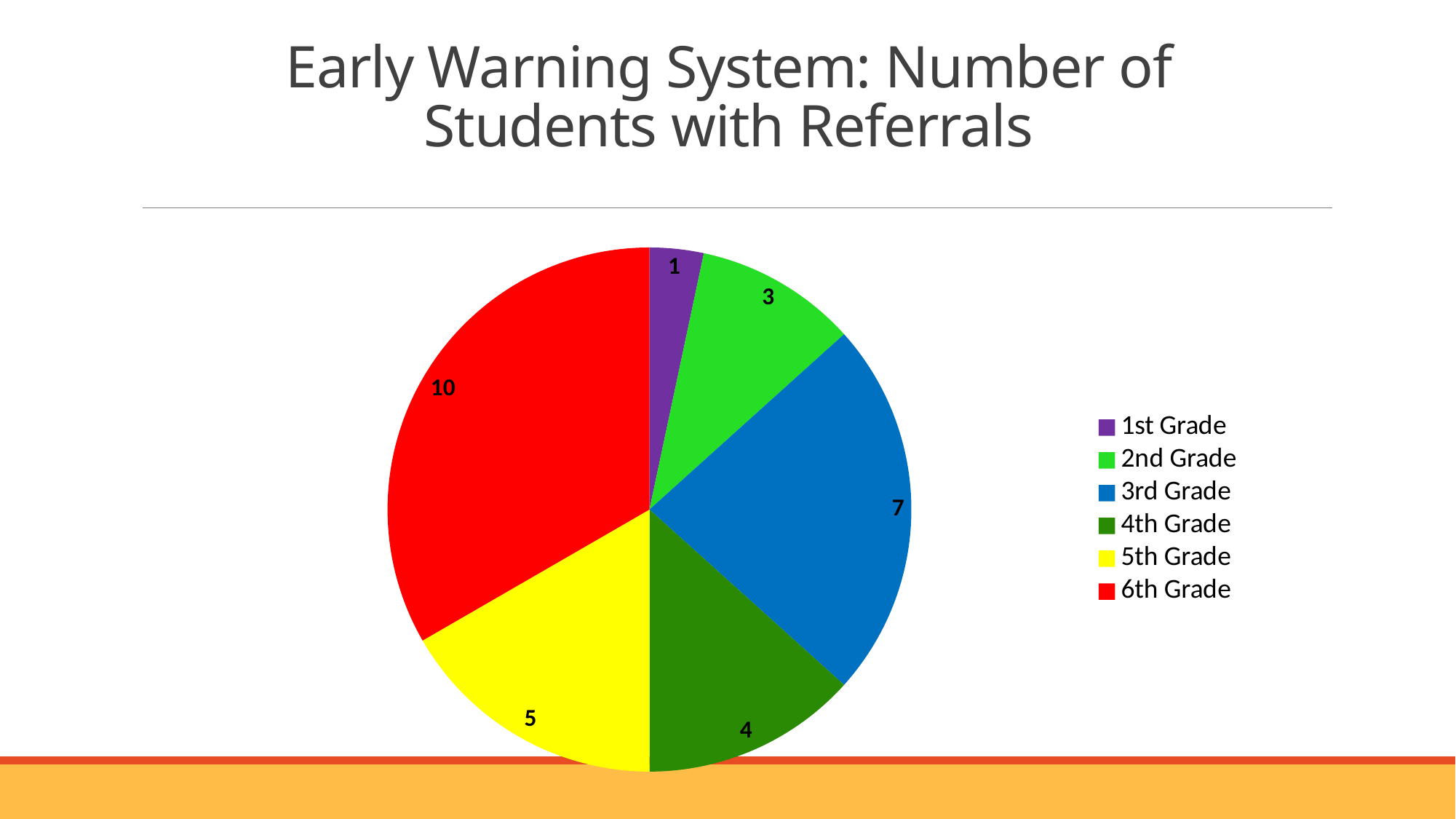
Which has more students with referrals, 2nd Grade or 4th Grade? 4th Grade Which grade has the lowest number of students with referrals? 1st Grade What share of the pie does the 5th Grade slice represent? 5 out of 30 How many students with referrals are in 3rd Grade? 7 How many students with referrals are in 6th Grade? 10 What colour represents 3rd Grade in the pie chart? blue What is the difference between the number of students with referrals in 6th Grade and 5th Grade? 5 What type of chart is shown on the slide? pie chart Which grade has the highest number of students with referrals? 6th Grade How many students with referrals are in 1st Grade? 1 What is the total number of students with referrals across all grades? 30 How many grade categories are shown in the pie chart? 6